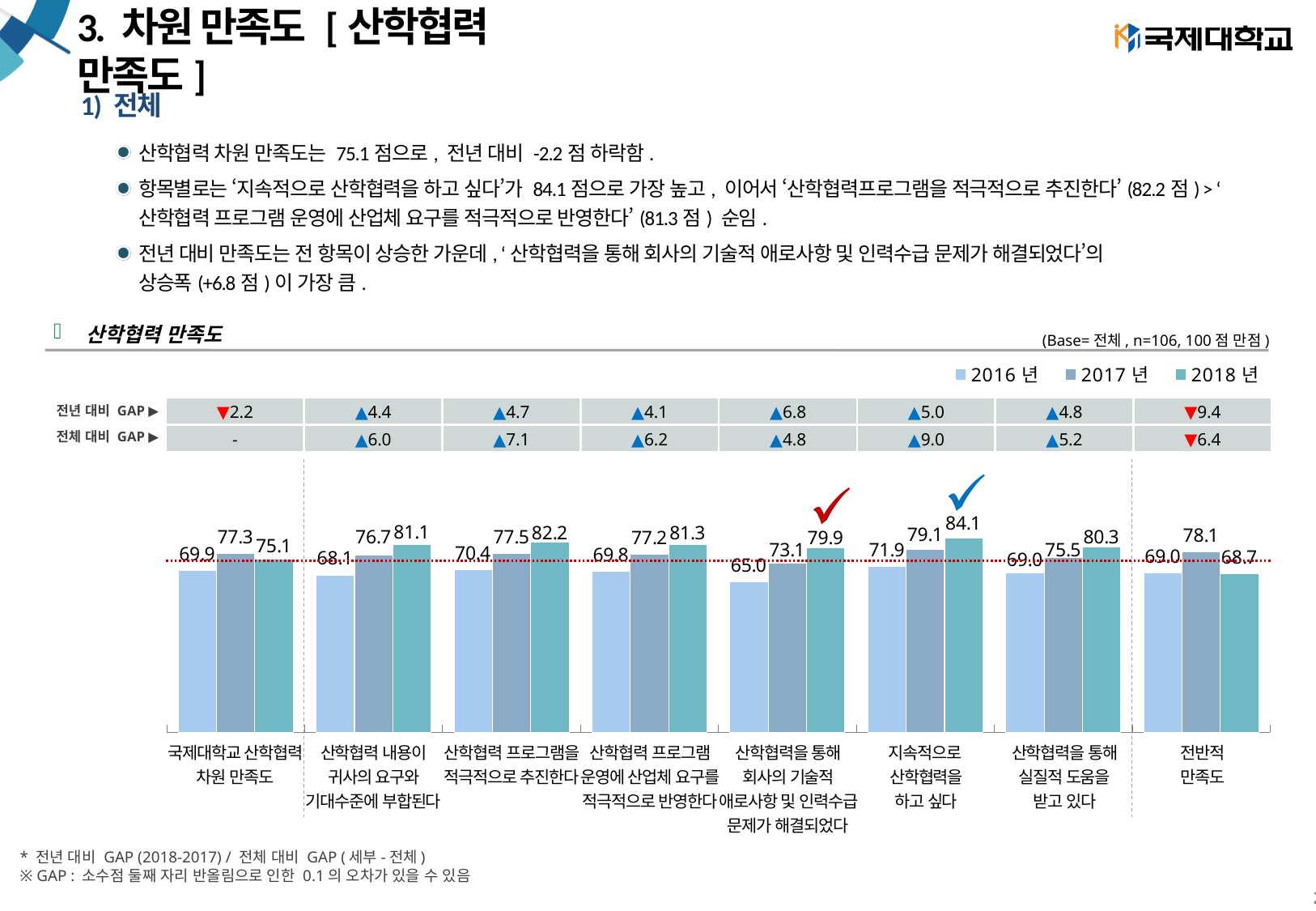
What is the 2018년 value for '지속적으로 산학협력을 하고 싶다'? 84.1 What kind of chart is shown on the slide? bar chart How many series does the legend list? 3 Which category has the highest 2018년 value? 지속적으로 산학협력을 하고 싶다 How many categories are shown on the x axis of the chart? 8 What is the 2017년 value for '전반적 만족도'? 78.1 Which category has the lowest 2016년 value? 산학협력을 통해 회사의 기술적 애로사항 및 인력수급 문제가 해결되었다 What is the 전년 대비 GAP shown for '전반적 만족도'? ▼9.4 What is the 2016년 value for '산학협력을 통해 회사의 기술적 애로사항 및 인력수급 문제가 해결되었다'? 65.0 For '산학협력 내용이 귀사의 요구와 기대수준에 부합된다', do the values rise or fall from 2016년 to 2018년? rise For '전반적 만족도', which is larger: the 2017년 value or the 2018년 value? 2017년 What is the difference between the 2018년 and 2017년 values for '산학협력 프로그램을 적극적으로 추진한다'? 4.7